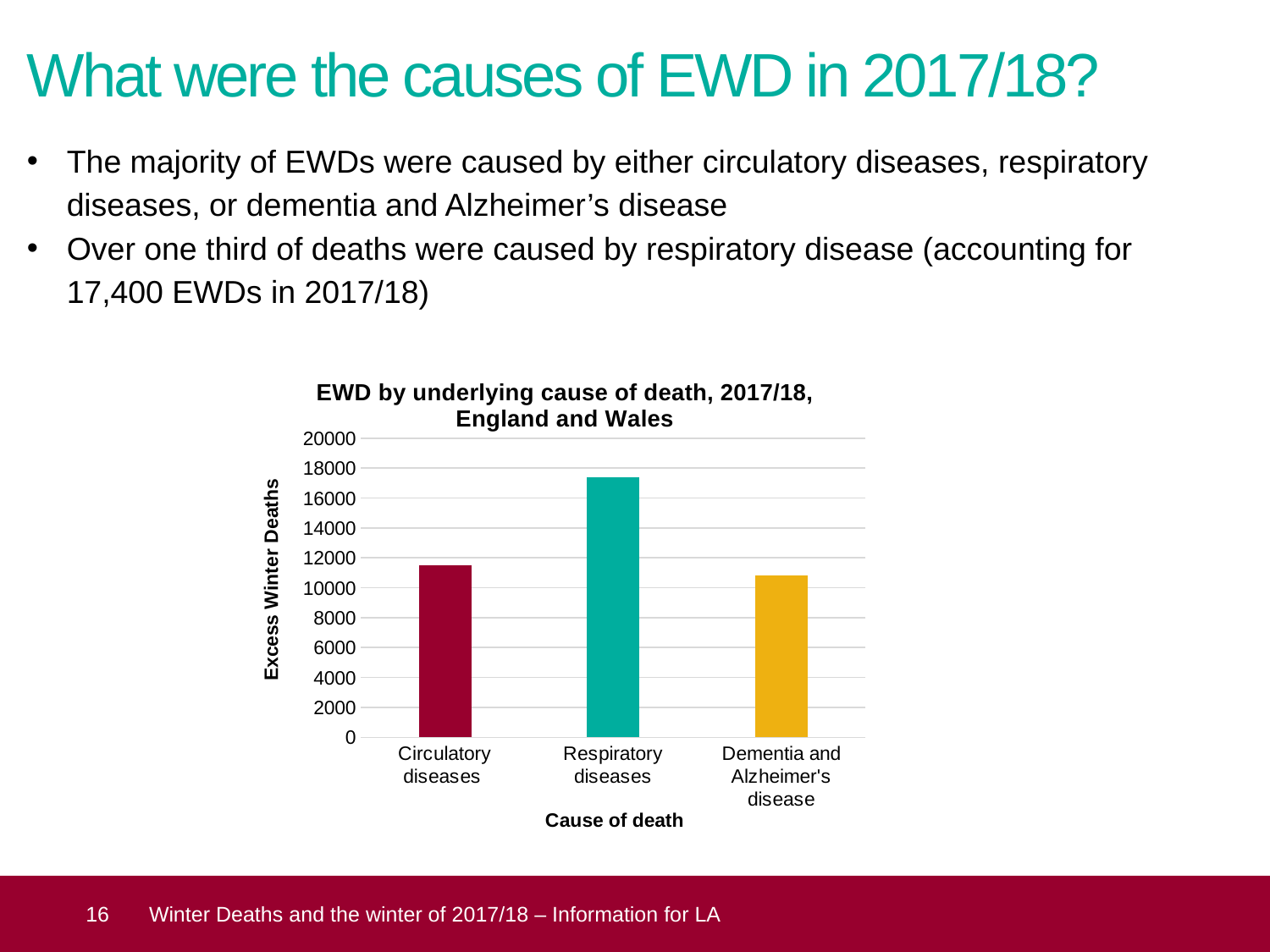
What kind of chart is shown on the slide? Bar chart Which cause of death has the highest number of excess winter deaths? Respiratory diseases Is the value for circulatory diseases greater or less than 10000? greater Which cause of death has the lowest number of excess winter deaths? Dementia and Alzheimer's disease Is the value for respiratory diseases greater or less than 16000? greater Which has more excess winter deaths: circulatory diseases or dementia and Alzheimer's disease? Circulatory diseases What is the title of the chart? EWD by underlying cause of death, 2017/18, England and Wales How many causes of death are plotted on the chart? 3 Is the value for circulatory diseases greater or less than 14000? less Which has more excess winter deaths: respiratory diseases or circulatory diseases? Respiratory diseases What is the label of the vertical axis of the chart? Excess Winter Deaths